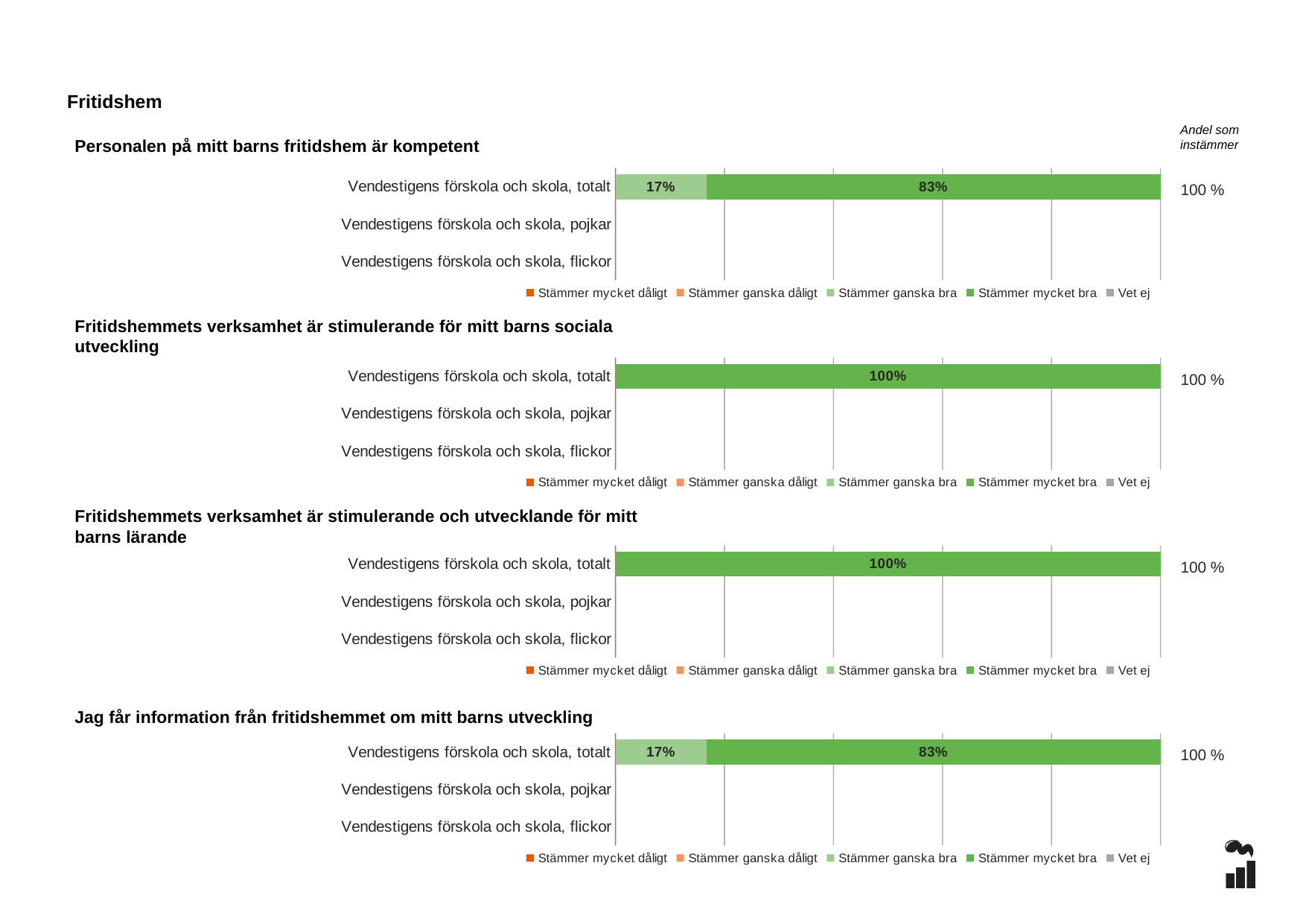
How many charts are shown on the slide? 4 How many series does the legend list in the chart 'Fritidshemmets verksamhet är stimulerande och utvecklande för mitt barns lärande'? 5 In the chart 'Fritidshemmets verksamhet är stimulerande för mitt barns sociala utveckling', what is the value for 'Stämmer mycket bra' for Vendestigens förskola och skola, totalt? 100% In the chart 'Personalen på mitt barns fritidshem är kompetent', what is the difference between the 'Stämmer mycket bra' and 'Stämmer ganska bra' values for Vendestigens förskola och skola, totalt? 66% What is the last legend entry in the chart 'Personalen på mitt barns fritidshem är kompetent'? Vet ej In the chart 'Jag får information från fritidshemmet om mitt barns utveckling', what is the value for 'Stämmer ganska bra' for Vendestigens förskola och skola, totalt? 17% What kind of chart is 'Fritidshemmets verksamhet är stimulerande för mitt barns sociala utveckling'? Stacked bar chart In the chart 'Personalen på mitt barns fritidshem är kompetent', what is the value for 'Stämmer ganska bra' for Vendestigens förskola och skola, totalt? 17% How many categories are shown on the y axis of the chart 'Jag får information från fritidshemmet om mitt barns utveckling'? 3 In the chart 'Jag får information från fritidshemmet om mitt barns utveckling', which is larger for Vendestigens förskola och skola, totalt: 'Stämmer mycket bra' or 'Stämmer ganska bra'? Stämmer mycket bra In the chart 'Personalen på mitt barns fritidshem är kompetent', what is the value for 'Stämmer mycket bra' for Vendestigens förskola och skola, totalt? 83% In the chart 'Personalen på mitt barns fritidshem är kompetent', what is the total of the stacked bar for Vendestigens förskola och skola, totalt? 100%